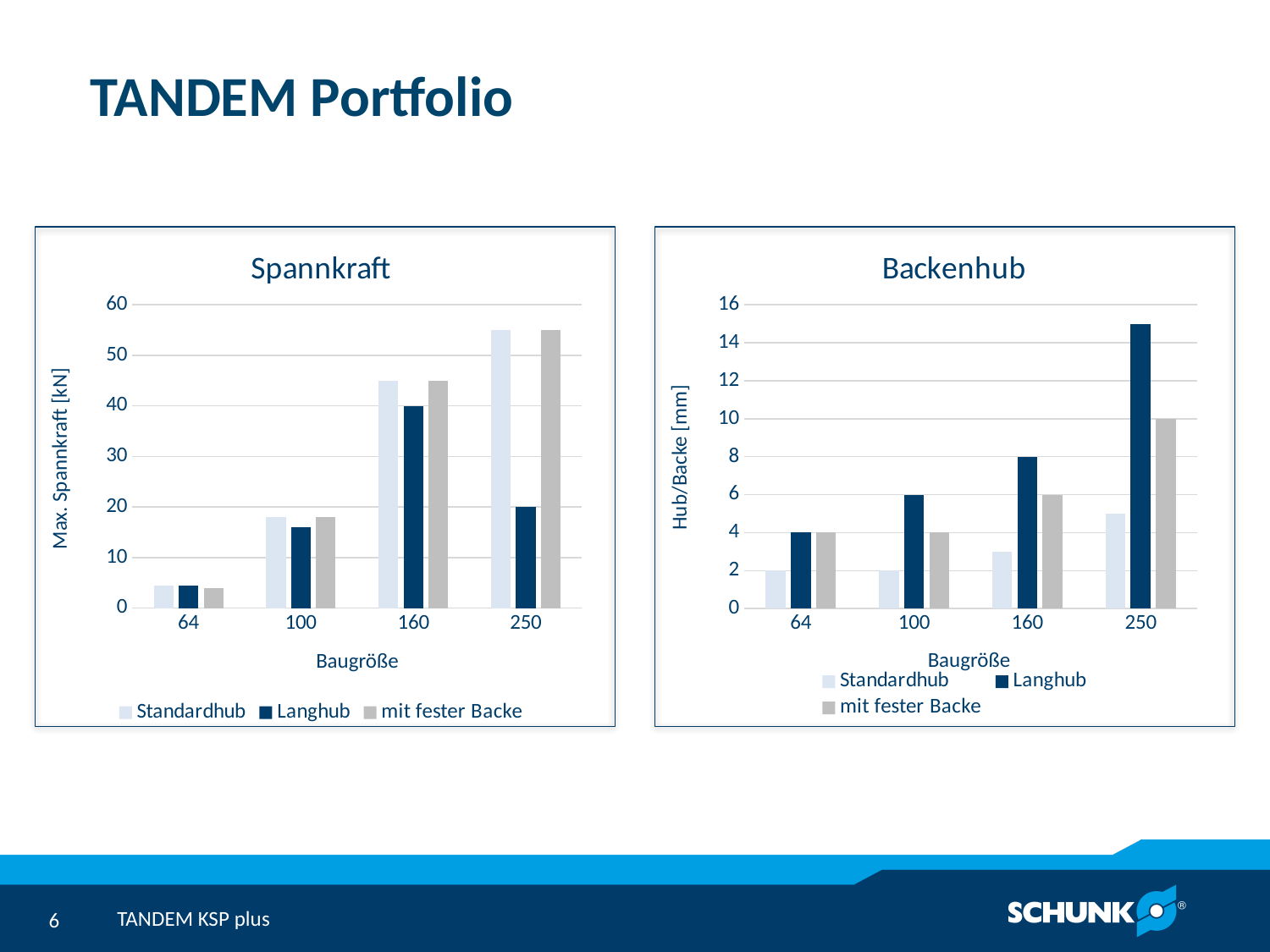
In the Backenhub chart, do the Langhub values rise or fall as Baugröße increases? rise In the Backenhub chart, what is the value for Langhub at Baugröße 160? 8 In the Spannkraft chart, what is the value for Langhub at Baugröße 160? 40 In the Spannkraft chart, what is the value for Langhub at Baugröße 250? 20 In the Spannkraft chart, how many series does the legend list? 3 In the Backenhub chart, what is the value for mit fester Backe at Baugröße 250? 10 In the Backenhub chart, which Baugröße has the highest Langhub value? 250 In the Spannkraft chart, which is larger at Baugröße 250: Standardhub or Langhub? Standardhub In the Backenhub chart, how many Baugröße categories are shown on the x axis? 4 In the Spannkraft chart, is the value for Standardhub at Baugröße 250 greater or less than 50? greater In the Spannkraft chart, which Baugröße has the lowest Langhub value? 64 What kind of chart is the Backenhub chart? bar chart